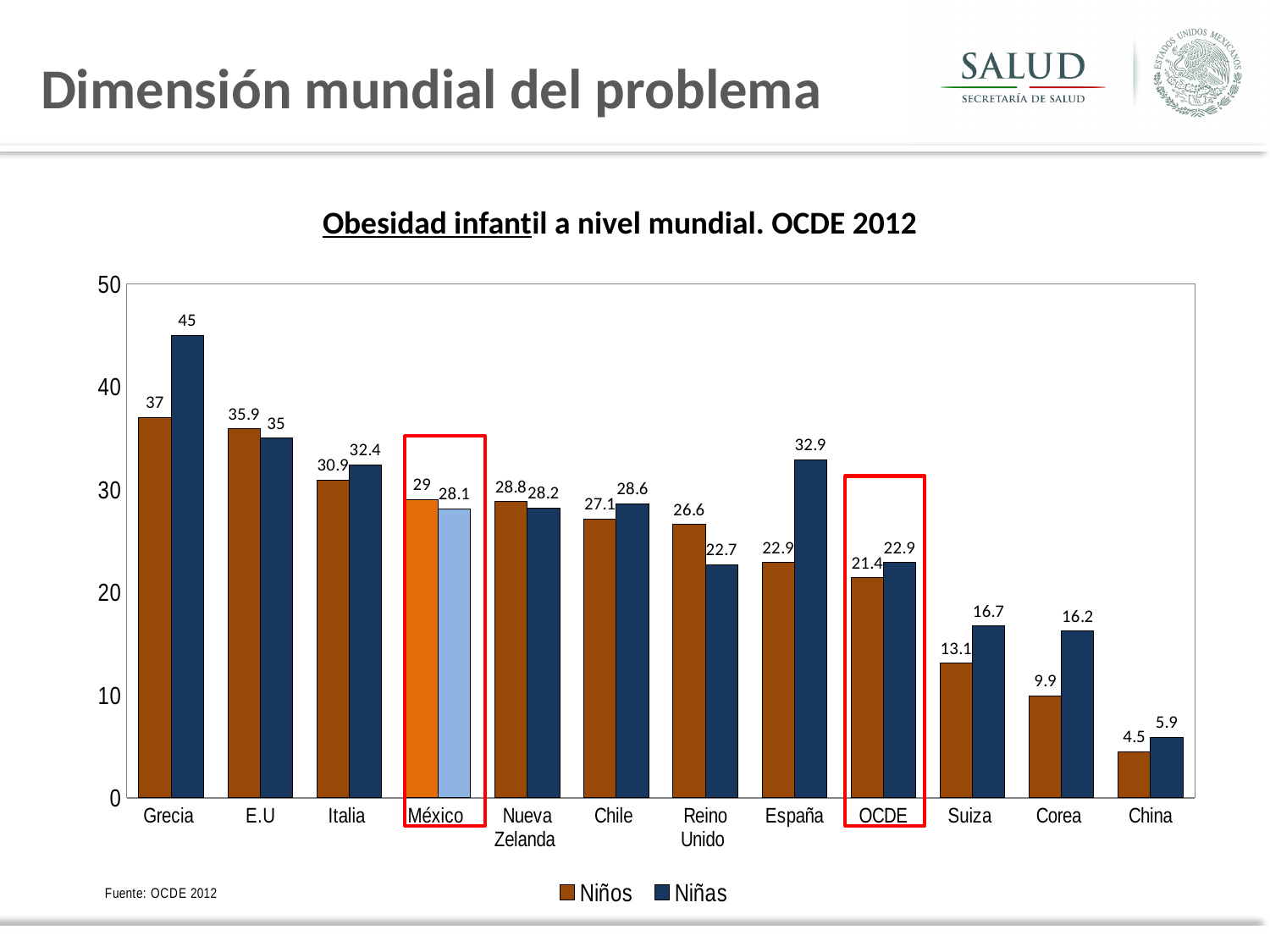
How many categories are shown on the x axis? 12 What kind of chart is shown on the slide? bar chart What is the difference between Niñas and Niños in España? 10 Which category has the highest value for Niñas? Grecia How many series does the legend list? 2 What is the value for Niños in OCDE? 21.4 Is the value for Niñas in Suiza greater or less than 20? less Which is larger in E.U, the value for Niños or the value for Niñas? Niños Which category has the lowest value for Niños? China What is the value for Niños in Grecia? 37 What is the value for Niñas in México? 28.1 What is the title of the chart? Obesidad infantil a nivel mundial. OCDE 2012